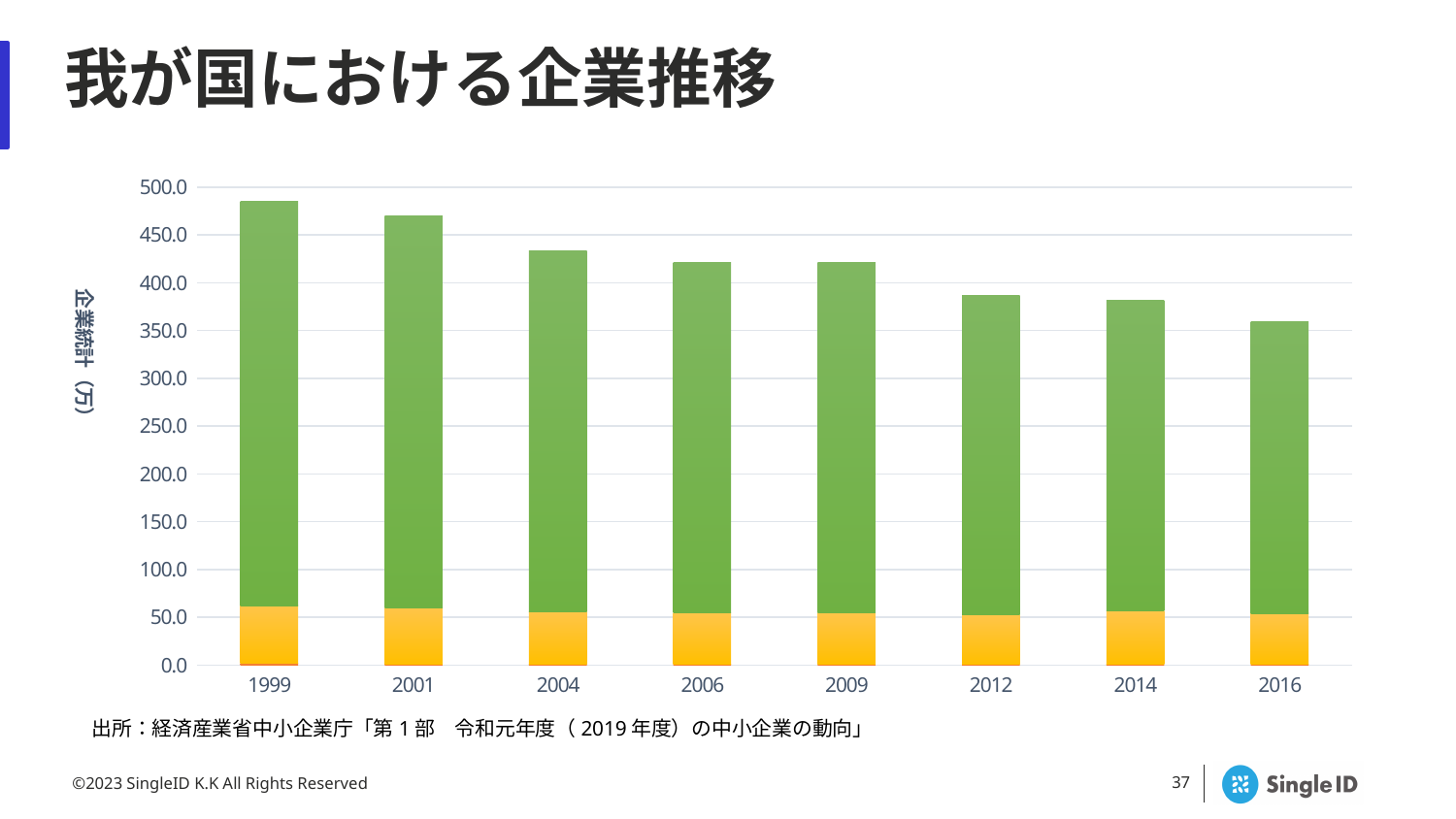
Is the total bar value for 2012 greater or less than 400? less Which year has the shortest bar in the chart? 2016 Which year has the tallest bar in the chart? 1999 Which bar is taller, 2004 or 2012? 2004 What is the title of the chart slide? 我が国における企業推移 Is the total bar value for 2016 greater or less than 400? less How many years are shown on the x axis of the chart? 8 Do the bar totals generally rise or fall from 1999 to 2016? Fall What is the label on the vertical axis of the chart? 企業統計（万） What kind of chart is shown on the slide? Stacked bar chart Is the total bar value for 1999 greater or less than 450? greater